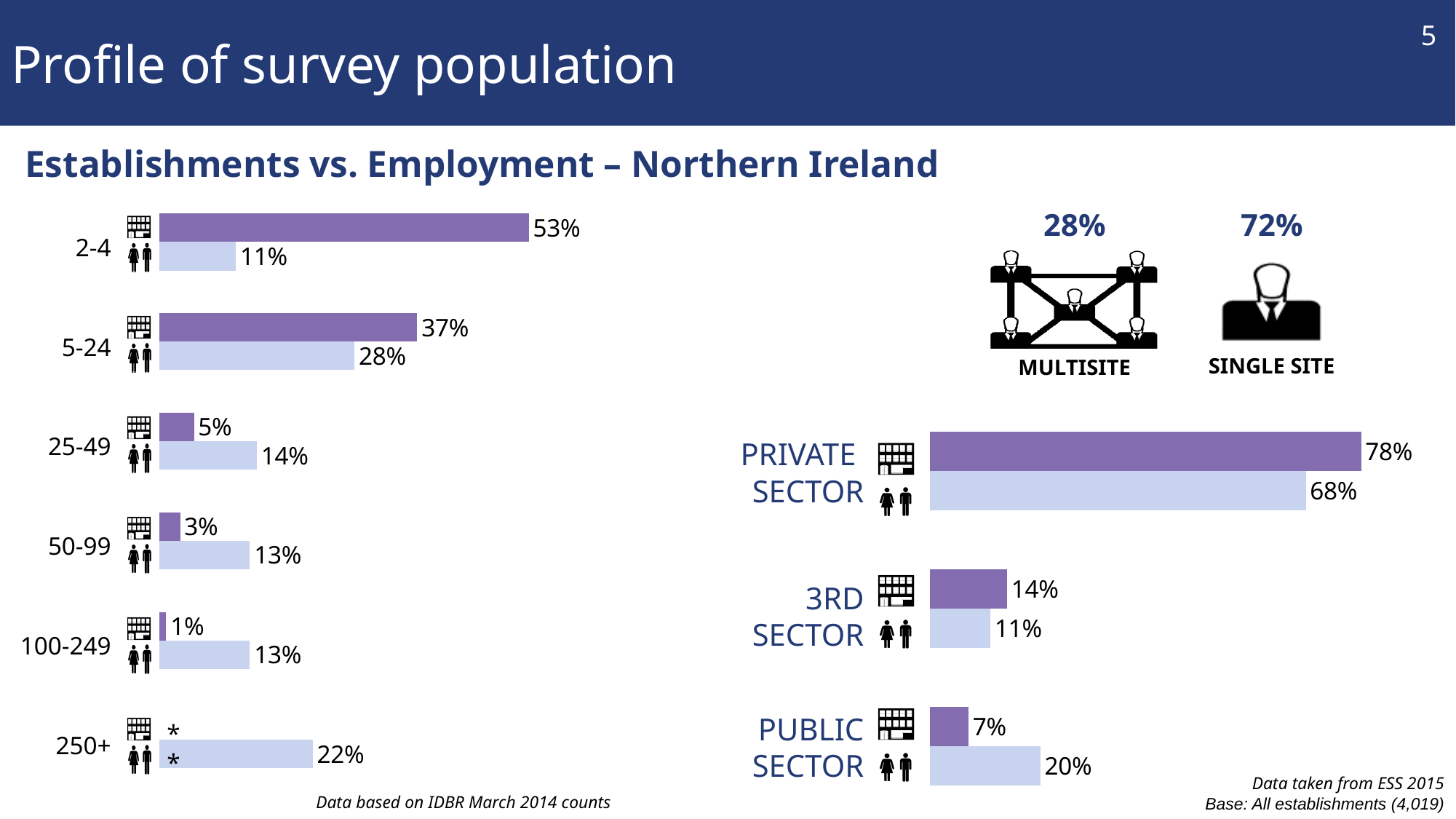
In the right chart (sectors), what percentage of establishments is shown for the 3rd sector (dark purple bar)? 14% What percentage is shown for multisite establishments on the slide? 28% In the left chart (size bands), which size band has the highest establishments percentage (dark purple bar)? 2-4 In the right chart (sectors), which sector has the highest establishments percentage (dark purple bar)? Private sector In the left chart (size bands), what percentage of employment is shown for the 5-24 band (light bar)? 28% In the left chart (size bands), what percentage of establishments is shown for the 2-4 band (dark purple bar)? 53% In the right chart (sectors), what is the difference between the private sector establishments value (78%) and its employment value (68%)? 10 percentage points In the left chart (size bands), for the 25-49 band, which is larger: the establishments bar or the employment bar? Employment (14%) What type of chart is used on the left side of the slide for the size bands? Bar chart In the left chart (size bands), what is the difference between the establishments value (53%) and the employment value (11%) for the 2-4 band? 42 percentage points In the right chart (sectors), what percentage of employment is shown for the public sector (light bar)? 20% How many size bands are shown in the left chart? 6